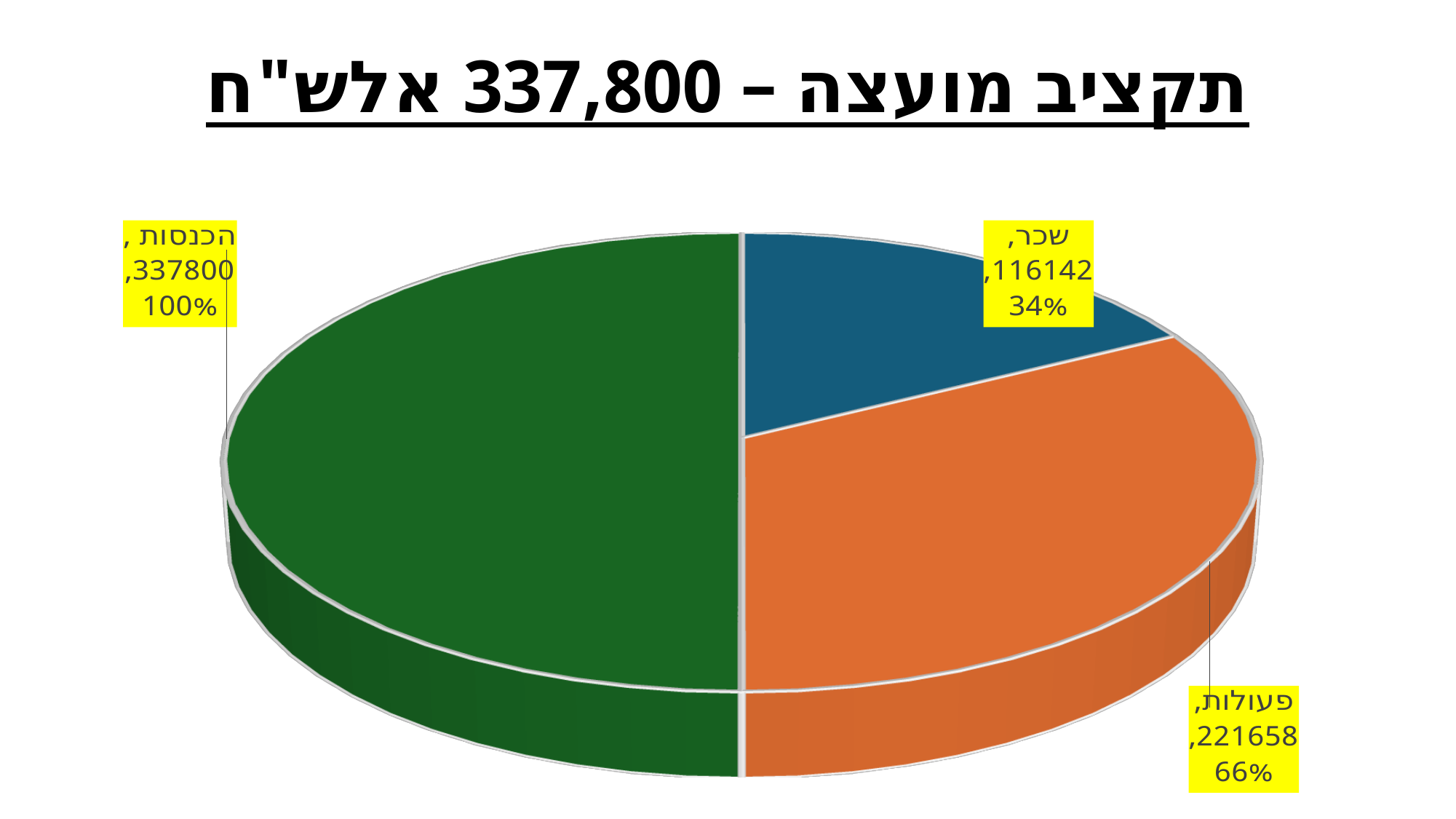
Which slice has the smallest value? שכר What kind of chart is shown on the slide? pie chart What is the difference between the פעולות value and the שכר value? 105516 What percentage is labelled on the שכר slice? 34% What value is shown for the שכר slice? 116142 How many slices does the pie chart have? 3 What value is shown for the פעולות slice? 221658 What percentage is labelled on the פעולות slice? 66% What is the title of the chart on the slide? תקציב מועצה – 337,800 אלש"ח What percentage is labelled on the הכנסות slice? 100% What value is shown for the הכנסות slice? 337800 Which is larger, the value for פעולות or the value for שכר? פעולות